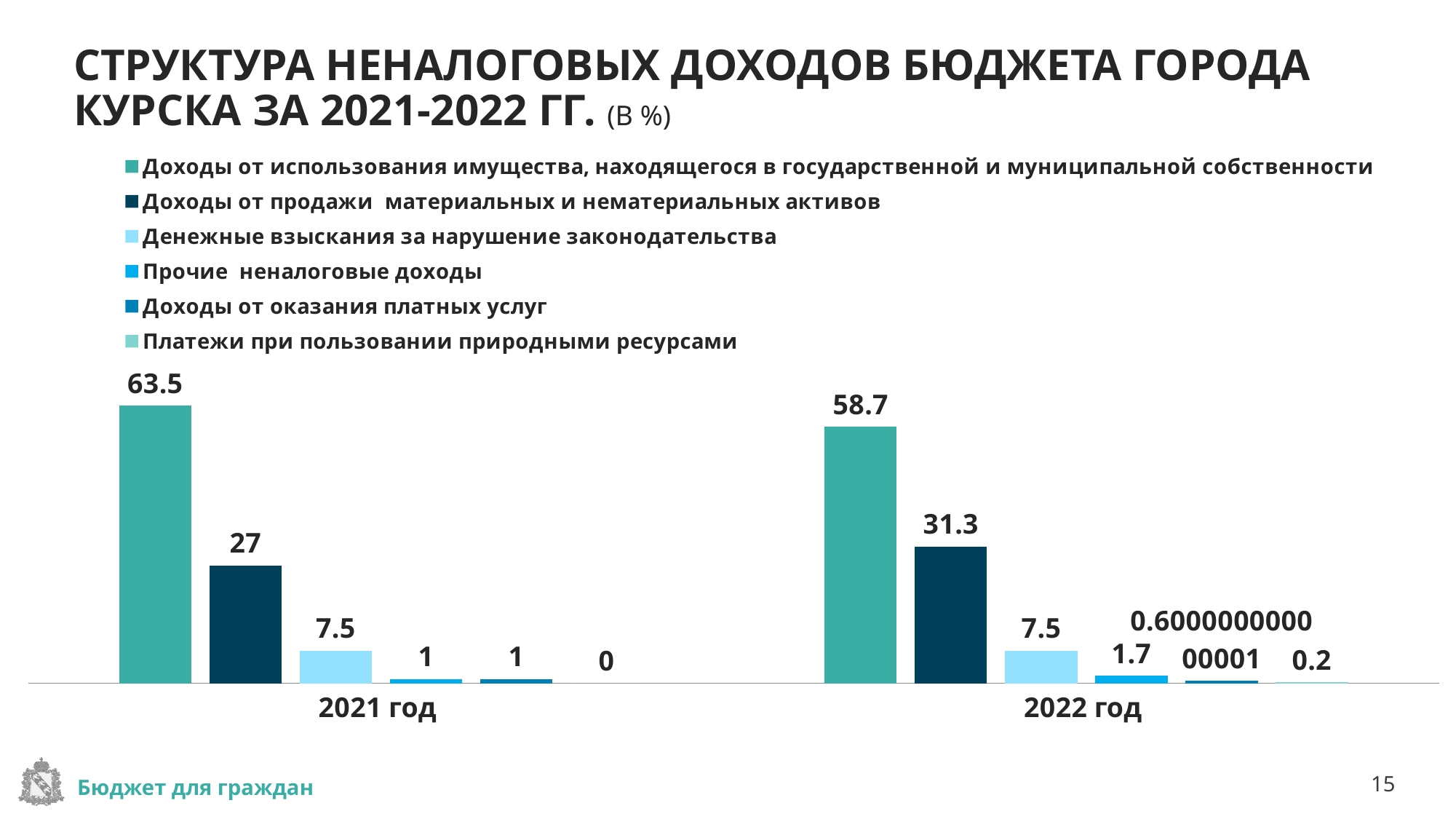
What kind of chart is shown on the slide? bar chart What is the value for «Платежи при пользовании природными ресурсами» in 2021 год? 0 What is the value for «Доходы от продажи материальных и нематериальных активов» in 2022 год? 31.3 By how much did «Доходы от использования имущества, находящегося в государственной и муниципальной собственности» decrease from 2021 год to 2022 год? 4.8 What is the value for «Доходы от использования имущества, находящегося в государственной и муниципальной собственности» in 2021 год? 63.5 How many series does the legend list? 6 What is the value for «Денежные взыскания за нарушение законодательства» in 2022 год? 7.5 How many year categories are shown on the x axis? 2 Which year has the larger value for «Доходы от продажи материальных и нематериальных активов», 2021 год or 2022 год? 2022 год Which series has the highest value in 2022 год? Доходы от использования имущества, находящегося в государственной и муниципальной собственности What is the value for «Прочие неналоговые доходы» in 2022 год? 1.7 What is the difference between the 2022 год and 2021 год values for «Доходы от продажи материальных и нематериальных активов»? 4.3